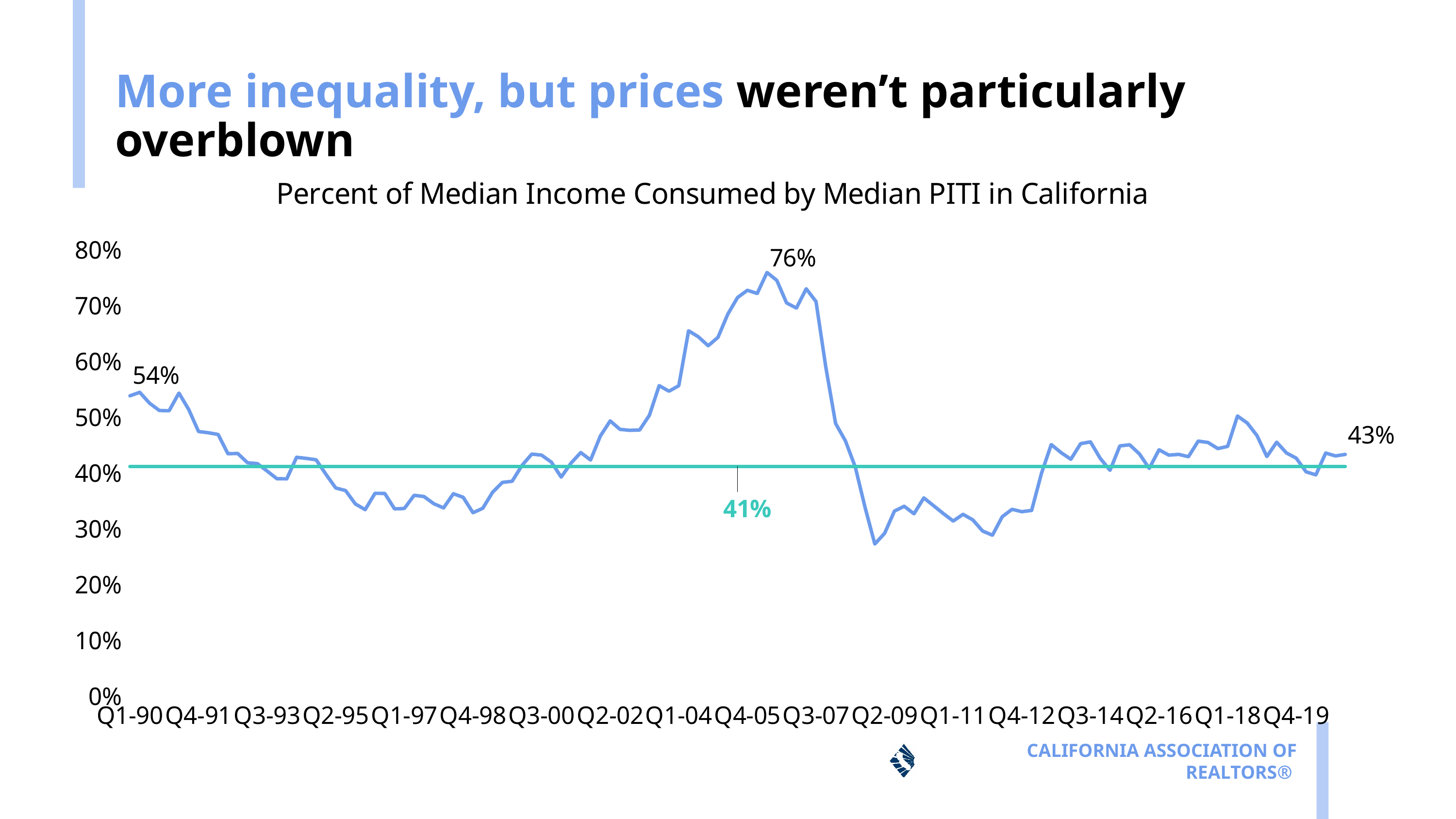
Do the values rise or fall from Q1-90 to Q3-93? fall Is the value for Q2-09 greater or less than 40%? less What is the highest value labeled on the line? 76% What is the title of the chart? Percent of Median Income Consumed by Median PITI in California Is the value for Q1-97 greater or less than 40%? less What value is labeled at the end of the line, at Q4-19? 43% What is the difference between the Q1-90 value and the Q4-19 value? 11 percentage points How much higher is the labeled peak of 76% than the starting value of 54%? 22 percentage points What kind of chart is shown on the slide? line chart What value is labeled at the start of the line, at Q1-90? 54% Which is larger, the value at Q1-90 or the value at Q4-19? Q1-90 What value is labeled on the horizontal reference line? 41%